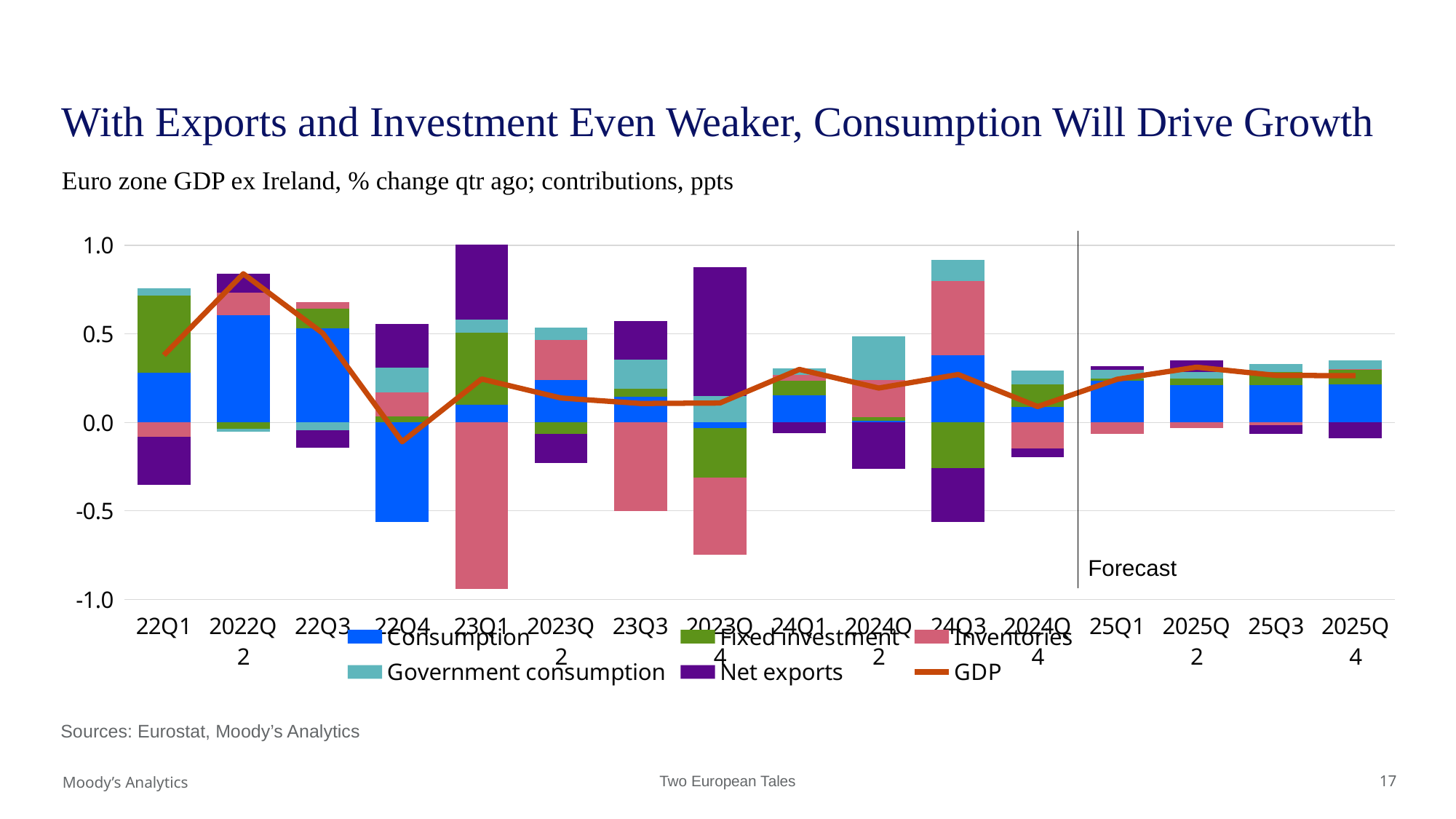
In which quarter does the GDP line reach its lowest value? 22Q4 How many quarters are shown along the x axis? 16 What kind of chart is shown on the slide? Stacked bar chart with a line In which quarter does the GDP line reach its highest value? 2022Q2 Which series is plotted as a line rather than as stacked bars? GDP How many series does the legend list? 6 Which quarter has the larger GDP value, 22Q3 or 23Q3? 22Q3 Is the Inventories contribution for 23Q1 greater or less than -0.5? less What label marks the section of the chart to the right of the vertical line? Forecast Does the GDP line rise or fall from 22Q1 to 2022Q2? rise Is the GDP value for 2022Q2 greater or less than 0.5? greater Is the GDP value for 22Q4 greater or less than 0.0? less